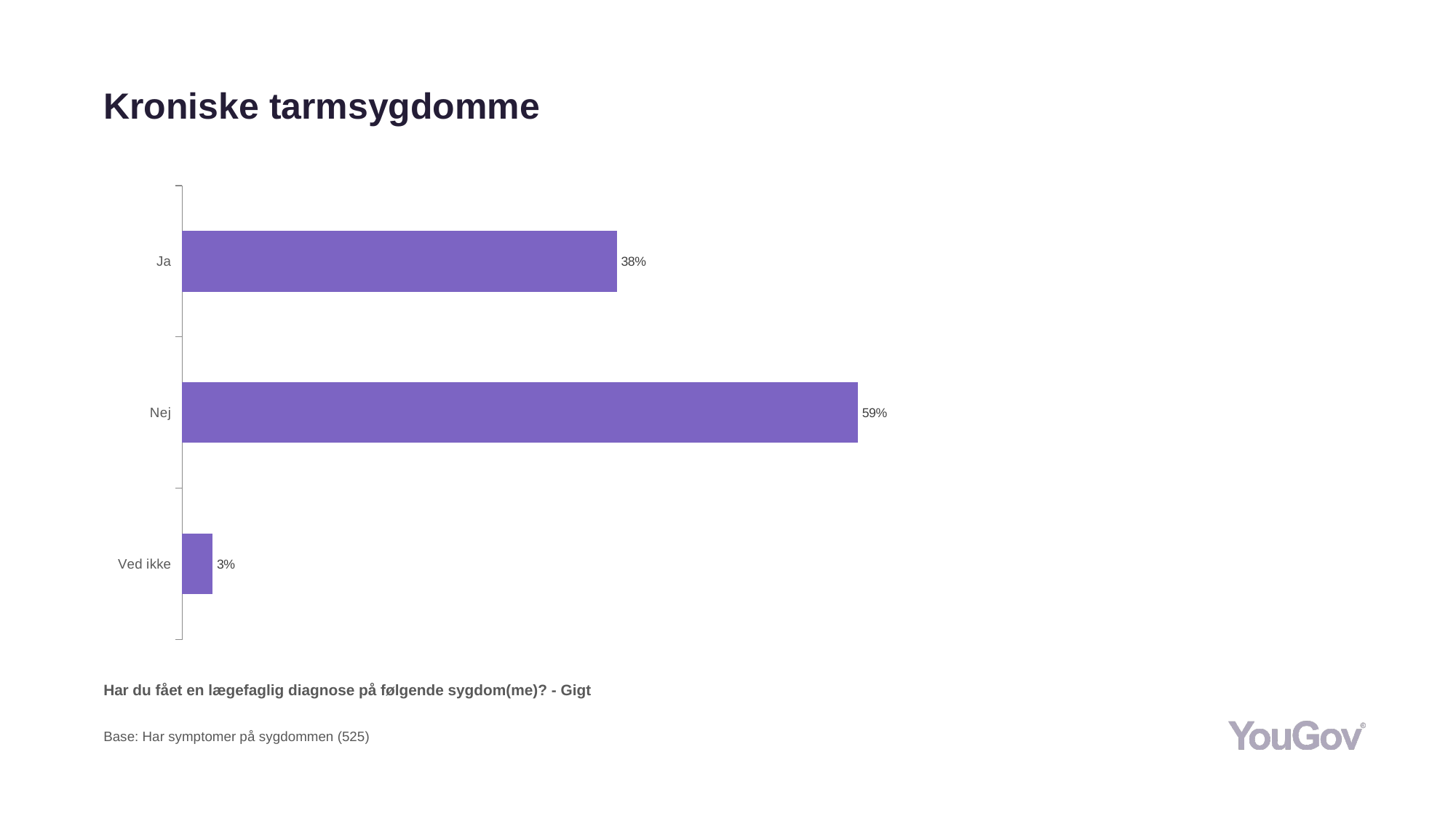
What is the title of the slide? Kroniske tarmsygdomme What is the value for "Ved ikke"? 3% What is the base size stated below the chart? 525 What is the difference between the values for "Nej" and "Ja"? 21% What is the value for "Ja"? 38% How many categories are shown in the chart? 3 Which category has the lowest value? Ved ikke Which category has the highest value? Nej What is the value for "Nej"? 59% Which is larger, the value for "Ja" or the value for "Nej"? Nej What is the difference between the values for "Ja" and "Ved ikke"? 35% What kind of chart is shown on the slide? Bar chart